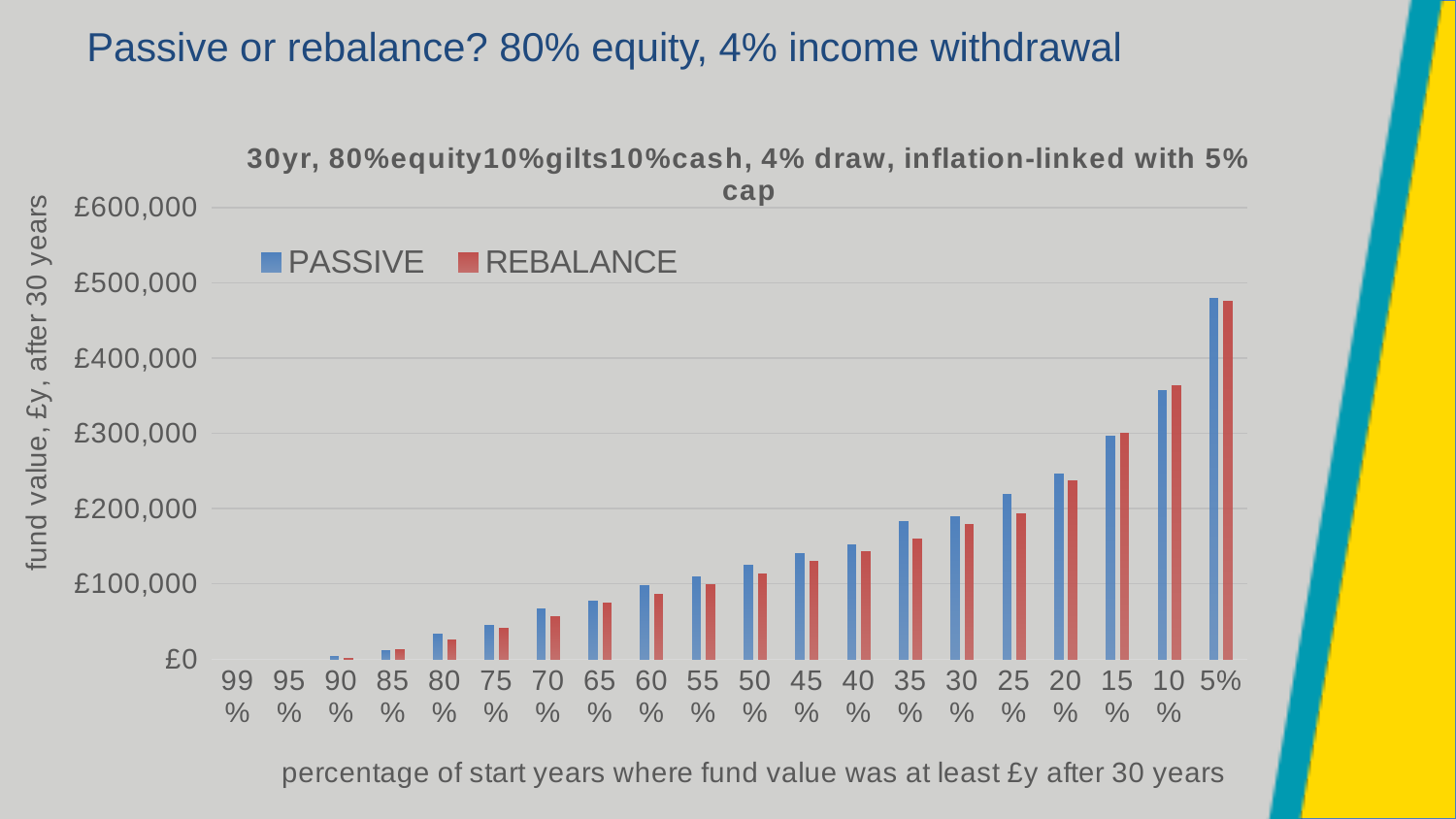
Is the PASSIVE value for 20% greater or less than £200,000? greater Is the REBALANCE value for 30% greater or less than £200,000? less How many categories are shown along the x axis? 20 Do the values rise or fall moving from 99% on the left to 5% on the right? rise What kind of chart is shown on the slide? bar chart At 25%, which series has the larger value, PASSIVE or REBALANCE? PASSIVE Is the PASSIVE value for 5% greater or less than £400,000? greater What are the two series named in the legend? PASSIVE and REBALANCE How many series does the chart legend list? 2 Which category has the highest PASSIVE value? 5%